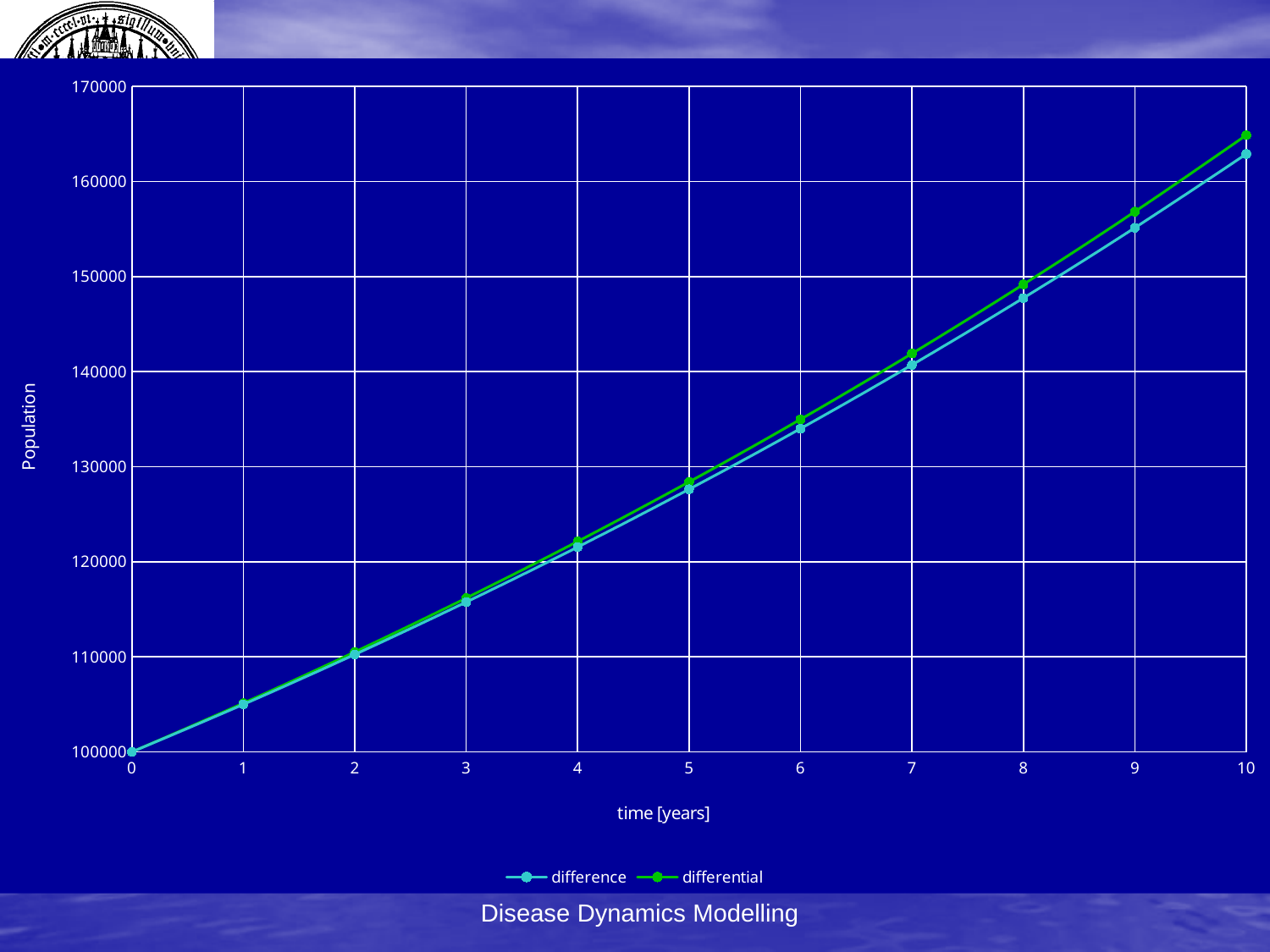
What are the names of the two series in the legend? difference and differential How many data points does the 'differential' series have? 11 What is the label of the x axis? time [years] Is the 'difference' value at time 8 greater or less than 150000? less What is the Population value of the 'difference' series at time 0? 100000 What kind of chart is shown on the slide? line chart How many series does the legend list? 2 At time 10, which series has the higher Population, 'difference' or 'differential'? differential Is the 'differential' value at time 5 greater or less than 130000? less Do the Population values rise or fall as time increases? rise Is the 'differential' value at time 10 greater or less than 160000? greater